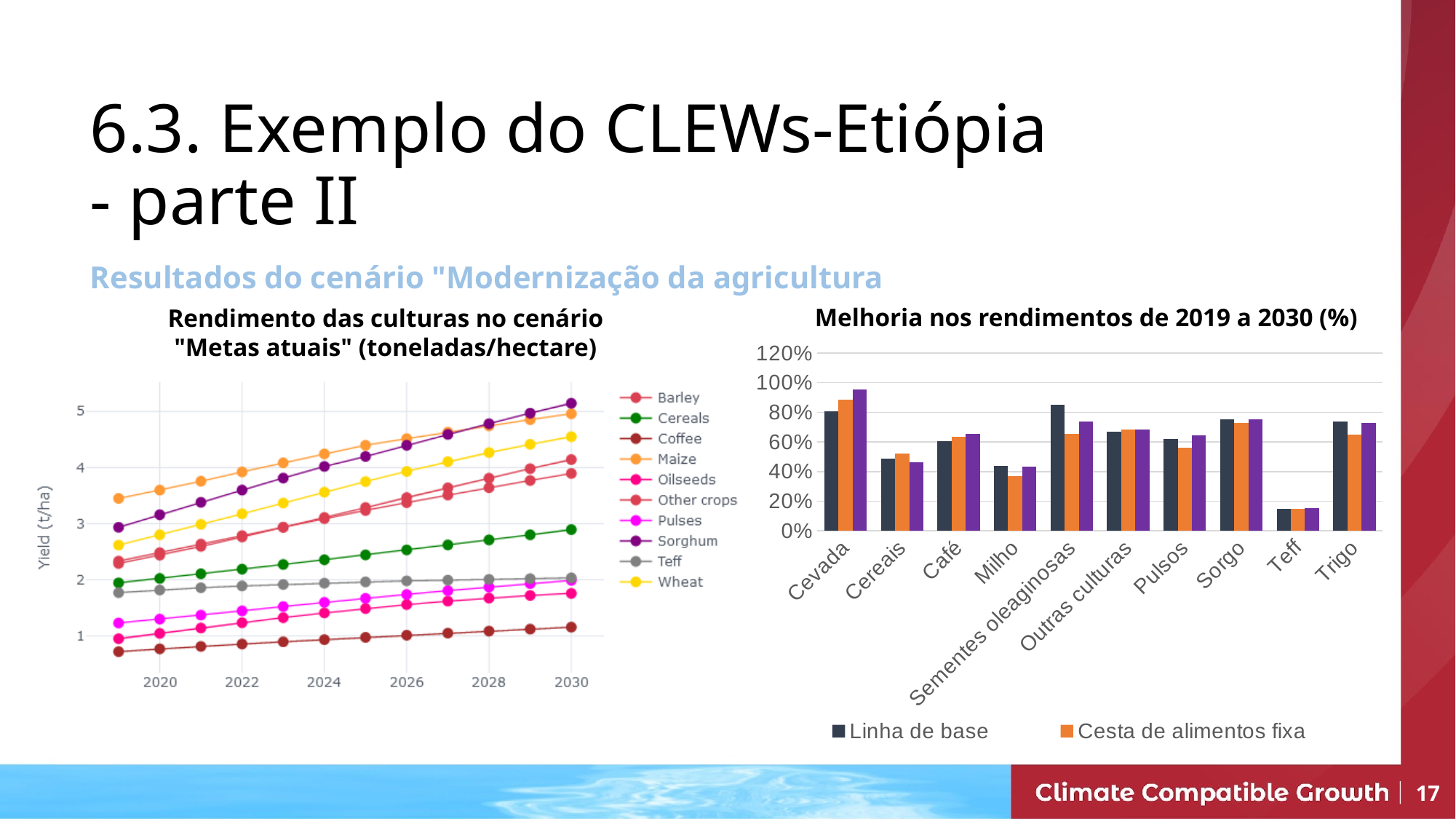
What kind of chart is the chart titled "Rendimento das culturas no cenário 'Metas atuais' (toneladas/hectare)"? line chart In the chart "Melhoria nos rendimentos de 2019 a 2030 (%)", which crop has the lowest values? Teff In the chart "Rendimento das culturas no cenário 'Metas atuais'", which crop has the highest yield in 2030? Sorghum In the chart "Rendimento das culturas no cenário 'Metas atuais'", which crop has the lowest yield across the period? Coffee In the chart "Melhoria nos rendimentos de 2019 a 2030 (%)", which has the larger Cesta de alimentos fixa value, Milho or Sorgo? Sorgo In the chart "Melhoria nos rendimentos de 2019 a 2030 (%)", which has the larger Linha de base value, Cevada or Cereais? Cevada What kind of chart is the chart titled "Melhoria nos rendimentos de 2019 a 2030 (%)"? bar chart In the chart "Melhoria nos rendimentos de 2019 a 2030 (%)", how many crop categories are shown on the x axis? 10 In the chart "Melhoria nos rendimentos de 2019 a 2030 (%)", is the Linha de base value for Cevada greater or less than 60%? greater In the chart "Rendimento das culturas no cenário 'Metas atuais'", how many series does the legend list? 10 In the chart "Rendimento das culturas no cenário 'Metas atuais'", does the Sorghum yield rise or fall from 2020 to 2030? rise In the chart "Melhoria nos rendimentos de 2019 a 2030 (%)", is the Linha de base value for Milho greater or less than 60%? less